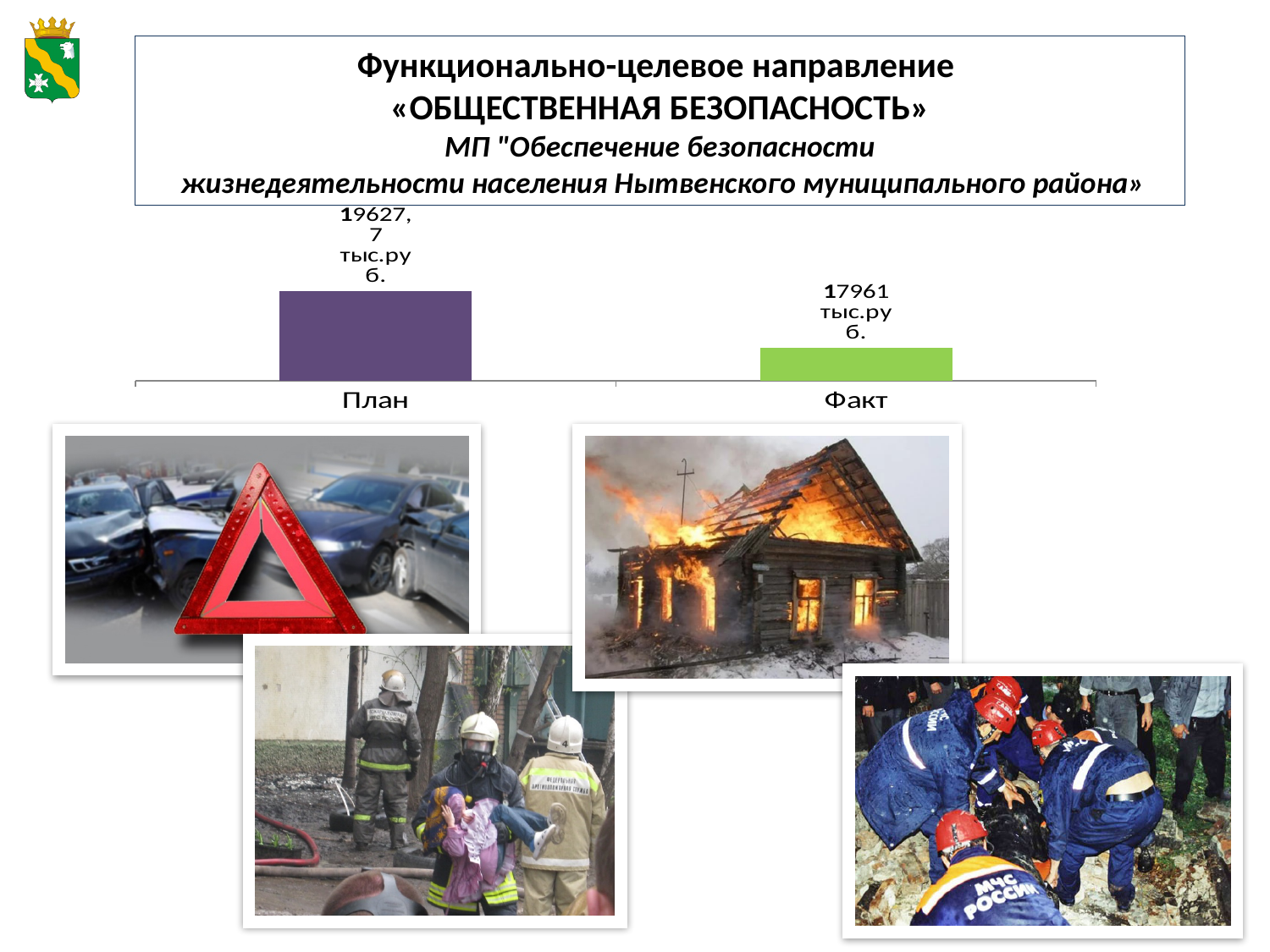
What is the difference between the План and Факт values? 1666,7 тыс.руб. Do the values rise or fall from План to Факт? Fall What colour is the bar for План? Purple Which category has the highest value? План Which category has the lowest value? Факт What is the value shown for План? 19627,7 тыс.руб. Which category has the higher value, План or Факт? План What is the value shown for Факт? 17961 тыс.руб. What colour is the bar for Факт? Green How many categories are shown on the chart? 2 What kind of chart is shown on the slide? Bar chart